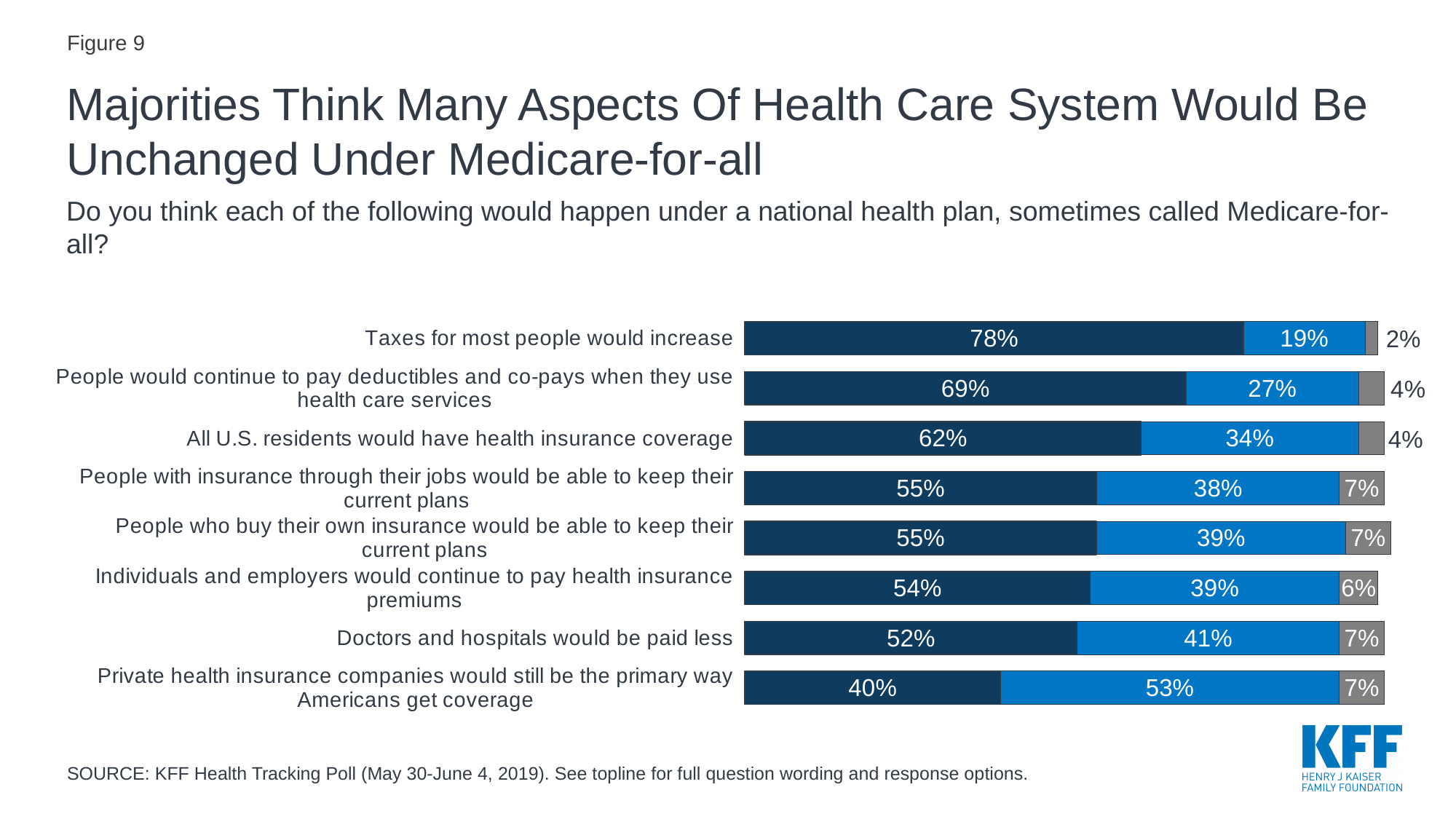
Which category has the smallest gray (third) segment? Taxes for most people would increase Which category has the lowest value in the dark blue (first) segment? Private health insurance companies would still be the primary way Americans get coverage Which is larger: the light blue segment for "Doctors and hospitals would be paid less" or the light blue segment for "Taxes for most people would increase"? Doctors and hospitals would be paid less What is the total of the three segments for "People would continue to pay deductibles and co-pays when they use health care services"? 100% What is the value of the gray (third) segment for "Doctors and hospitals would be paid less"? 7% What kind of chart is shown on the slide? Stacked horizontal bar chart What is the value of the light blue (second) segment for "All U.S. residents would have health insurance coverage"? 34% How many categories are shown in the chart? 8 What is the value of the dark blue (first) segment for "Taxes for most people would increase"? 78% What is the figure number shown on the slide? Figure 9 What is the difference between the dark blue segment values for "Taxes for most people would increase" and "Private health insurance companies would still be the primary way Americans get coverage"? 38 percentage points Which category has the highest value in the dark blue (first) segment? Taxes for most people would increase